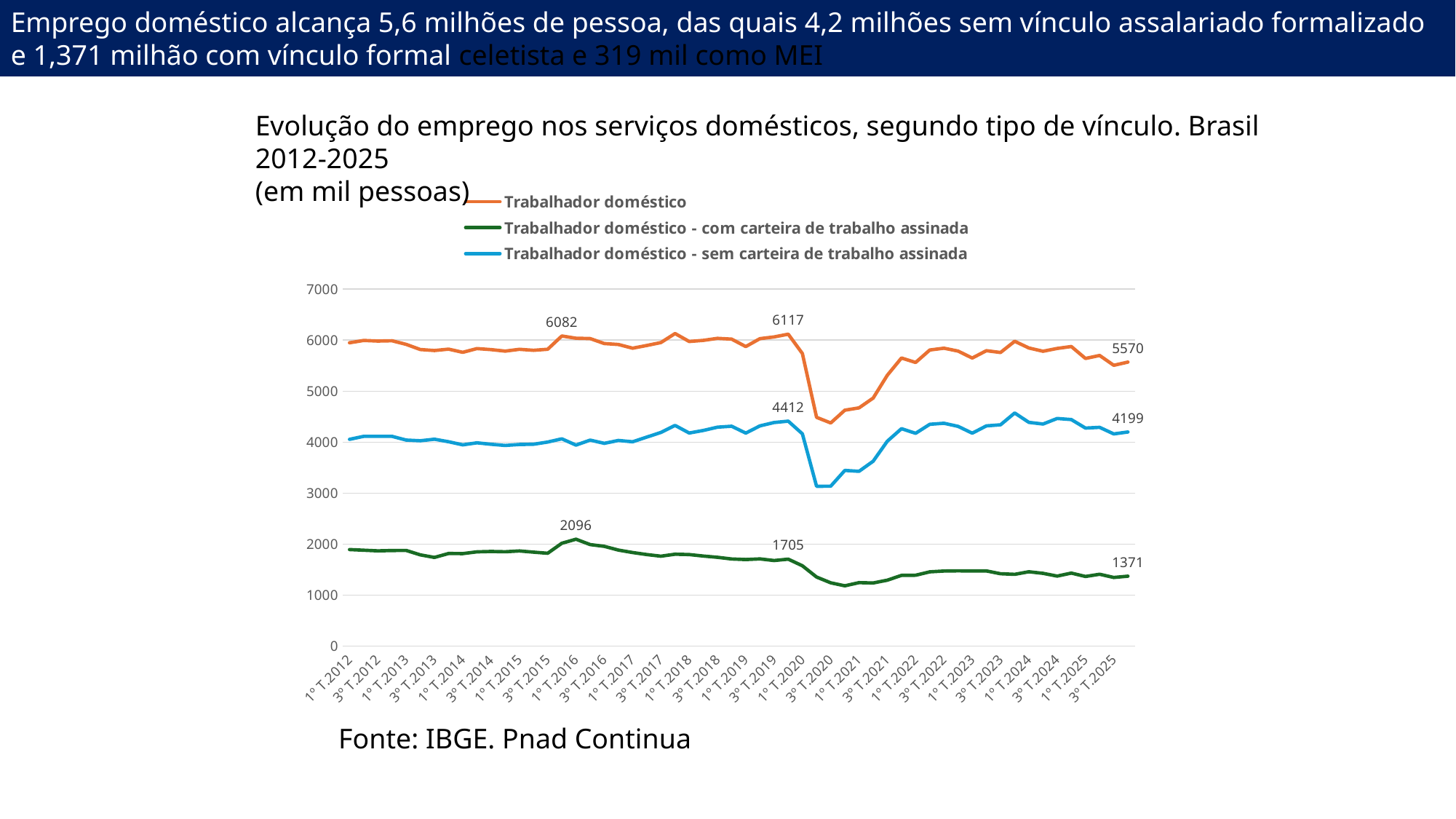
What kind of chart is shown on the slide? Line chart How many series does the legend list? 3 What is the value of 'Trabalhador doméstico - com carteira de trabalho assinada' at 1° T.2016? 2096 Does the 'Trabalhador doméstico - com carteira de trabalho assinada' series rise or fall between 1° T.2016 and 3° T.2025? Falls Is the value of 'Trabalhador doméstico - sem carteira de trabalho assinada' at 3° T.2020 greater or less than 4000? less At 3° T.2025, which is larger: the 'sem carteira de trabalho assinada' series or the 'com carteira de trabalho assinada' series? Sem carteira de trabalho assinada